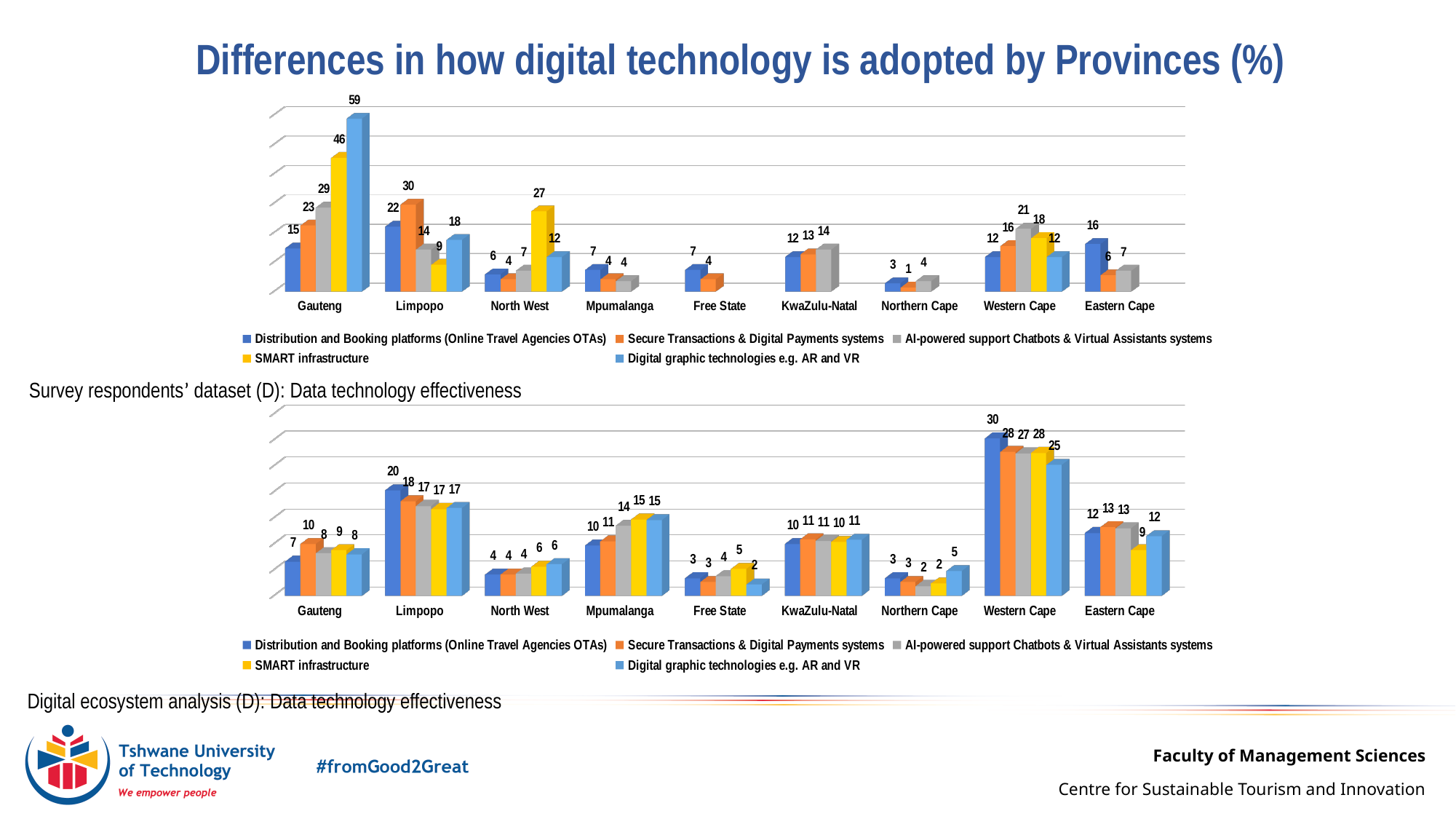
In the top chart, what is the value for Digital graphic technologies e.g. AR and VR in Gauteng? 59 How many provinces are shown on the x axis of the bottom chart? 9 In the top chart, what is the difference between the SMART infrastructure value and the Distribution and Booking platforms value for Gauteng? 31 In the bottom chart, what is the value for Distribution and Booking platforms (Online Travel Agencies OTAs) in Western Cape? 30 In the top chart, what is the value for SMART infrastructure in North West? 27 In the bottom chart, which province has the lowest value for Digital graphic technologies e.g. AR and VR? Free State In the top chart, which colour represents SMART infrastructure? Yellow In the top chart, which is larger: the AI-powered support Chatbots value for Western Cape or for KwaZulu-Natal? Western Cape In the top chart, which province has the highest value for Secure Transactions & Digital Payments systems? Limpopo How many series does the legend of the bottom chart list? 5 In the bottom chart, what is the difference between the SMART infrastructure values for Mpumalanga and Eastern Cape? 6 What type of chart is the bottom chart? Bar chart